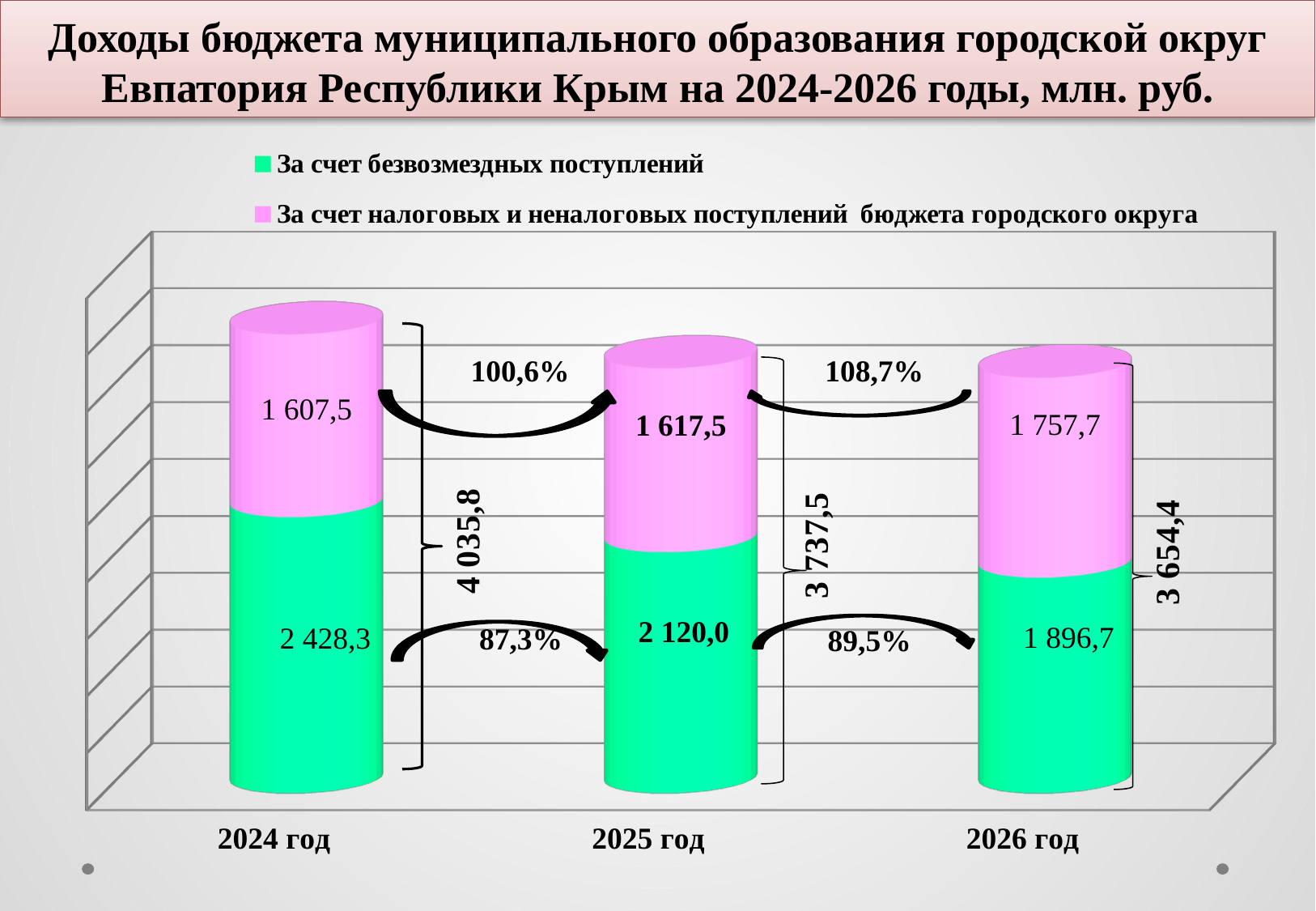
What is the value for 'За счет налоговых и неналоговых поступлений бюджета городского округа' in 2025 год? 1 617,5 What kind of chart is shown on the slide? Stacked bar chart What is the value for 'За счет безвозмездных поступлений' in 2024 год? 2 428,3 What is the total of the stacked bar for 2025 год? 3 737,5 What is the difference between 'За счет безвозмездных поступлений' and 'За счет налоговых и неналоговых поступлений бюджета городского округа' in 2024 год? 820,8 Do the total budget revenues rise or fall from 2024 год to 2026 год? Fall Which year has the highest total budget revenue? 2024 год Which is larger in 2026 год: 'За счет безвозмездных поступлений' or 'За счет налоговых и неналоговых поступлений бюджета городского округа'? За счет безвозмездных поступлений How many series does the legend list? 2 How many years (categories) are shown on the x axis? 3 Which year has the lowest value for 'За счет безвозмездных поступлений'? 2026 год What is the value for 'За счет налоговых и неналоговых поступлений бюджета городского округа' in 2026 год? 1 757,7